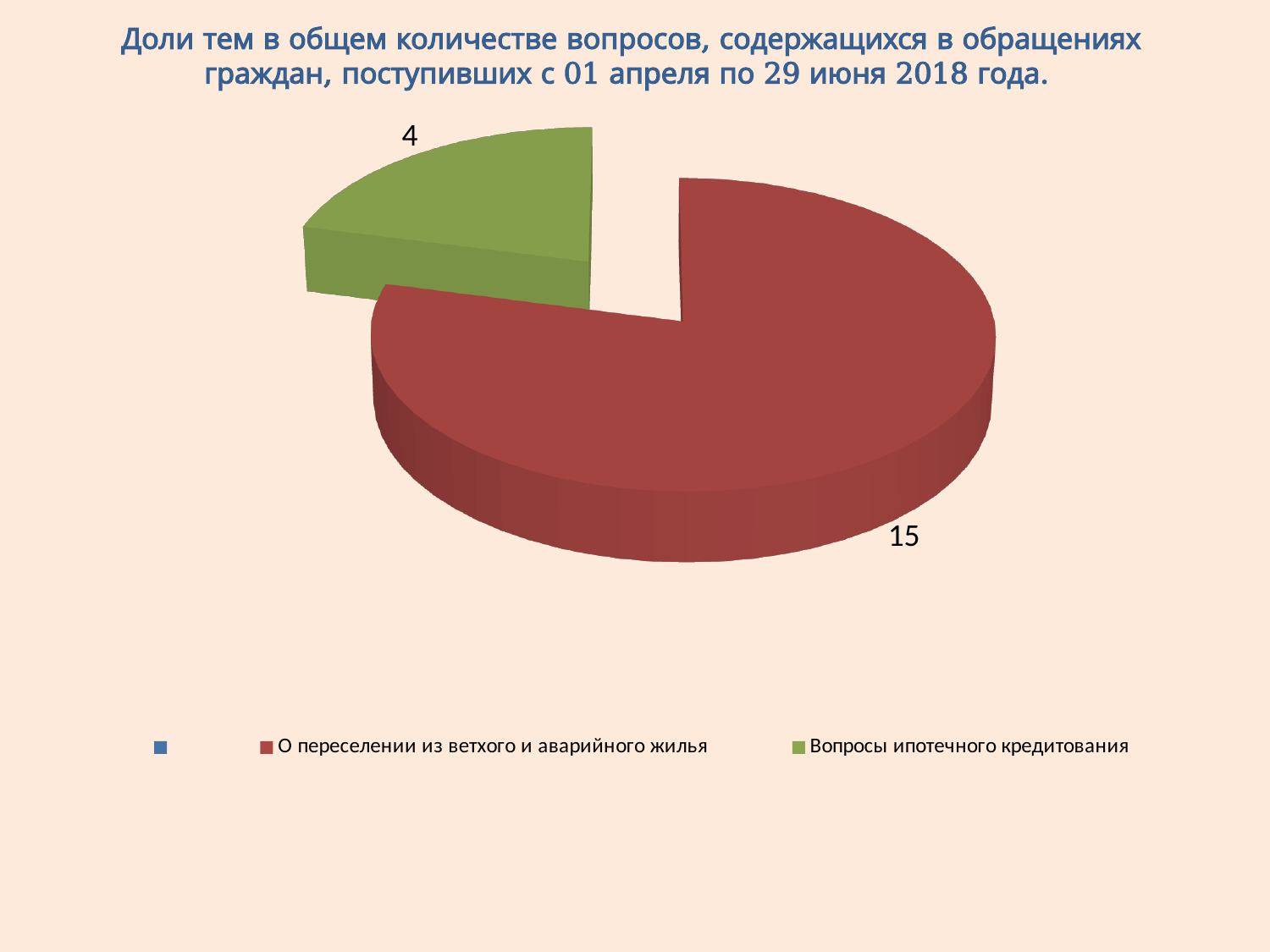
How many slices with data labels does the pie chart show? 2 What kind of chart is shown on the slide? Pie chart What is the value for "О переселении из ветхого и аварийного жилья"? 15 Which category has the smallest slice of the pie? Вопросы ипотечного кредитования What is the total of the two labelled slices in the pie chart? 19 What is the difference between the values for "О переселении из ветхого и аварийного жилья" and "Вопросы ипотечного кредитования"? 11 What is the value for "Вопросы ипотечного кредитования"? 4 What colour is the slice for "О переселении из ветхого и аварийного жилья"? Red Which is larger: the value for "О переселении из ветхого и аварийного жилья" or for "Вопросы ипотечного кредитования"? О переселении из ветхого и аварийного жилья What colour is the slice for "Вопросы ипотечного кредитования"? Green Which category has the largest slice of the pie? О переселении из ветхого и аварийного жилья